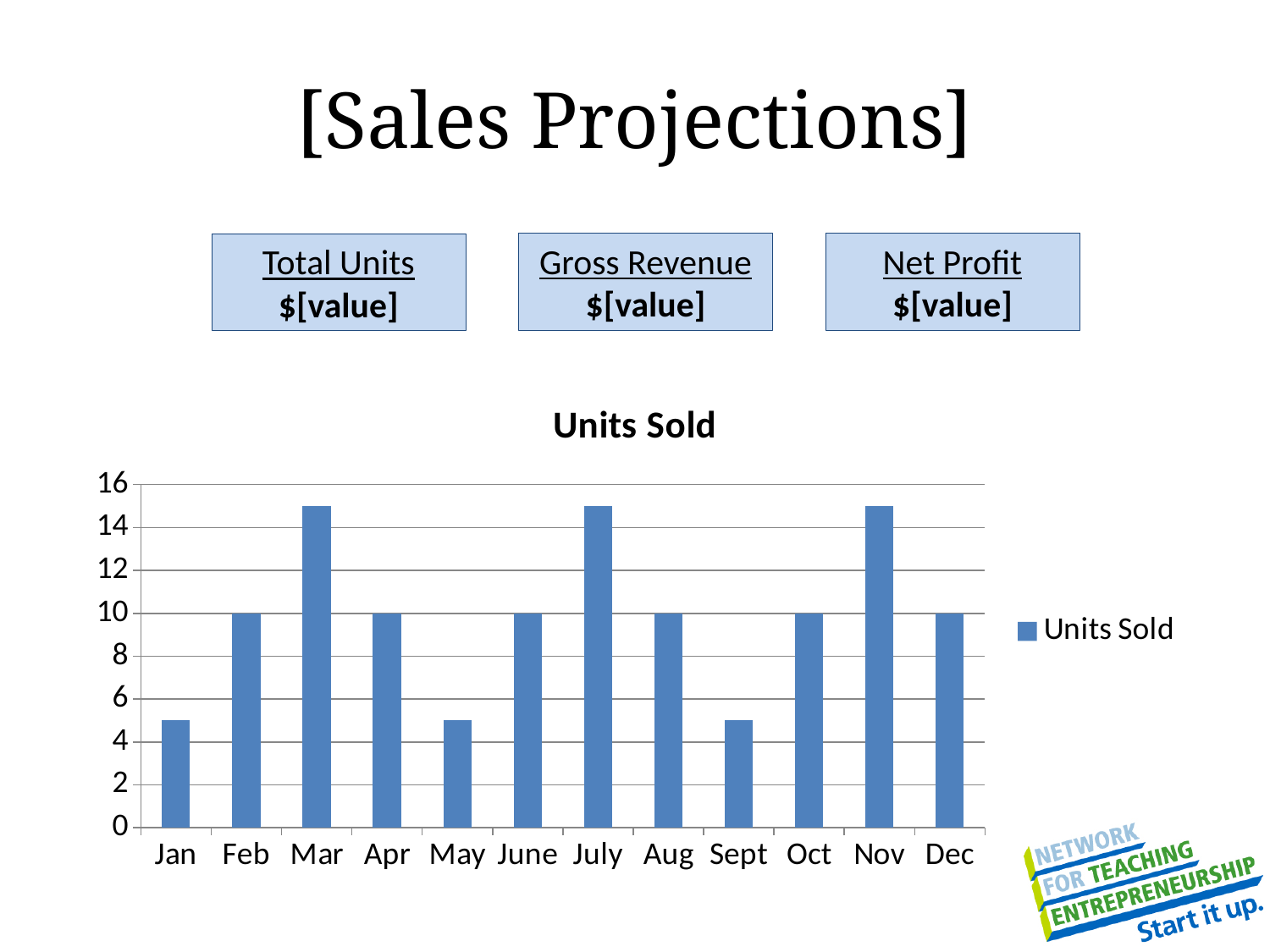
How many months are shown on the x axis of the Units Sold chart? 12 What is the value for Dec in the Units Sold chart? 10 Is the value for Sept greater or less than 8? less Which month has the larger value, May or June? June How many series does the legend of the Units Sold chart list? 1 Is the value for Mar greater or less than 14? greater Is the value for Jan greater or less than 6? less What type of chart is shown on the slide? bar chart What is the title of the chart? Units Sold What is the value for Oct in the Units Sold chart? 10 What is the value for Feb in the Units Sold chart? 10 Which month has the larger value, Mar or Feb? Mar